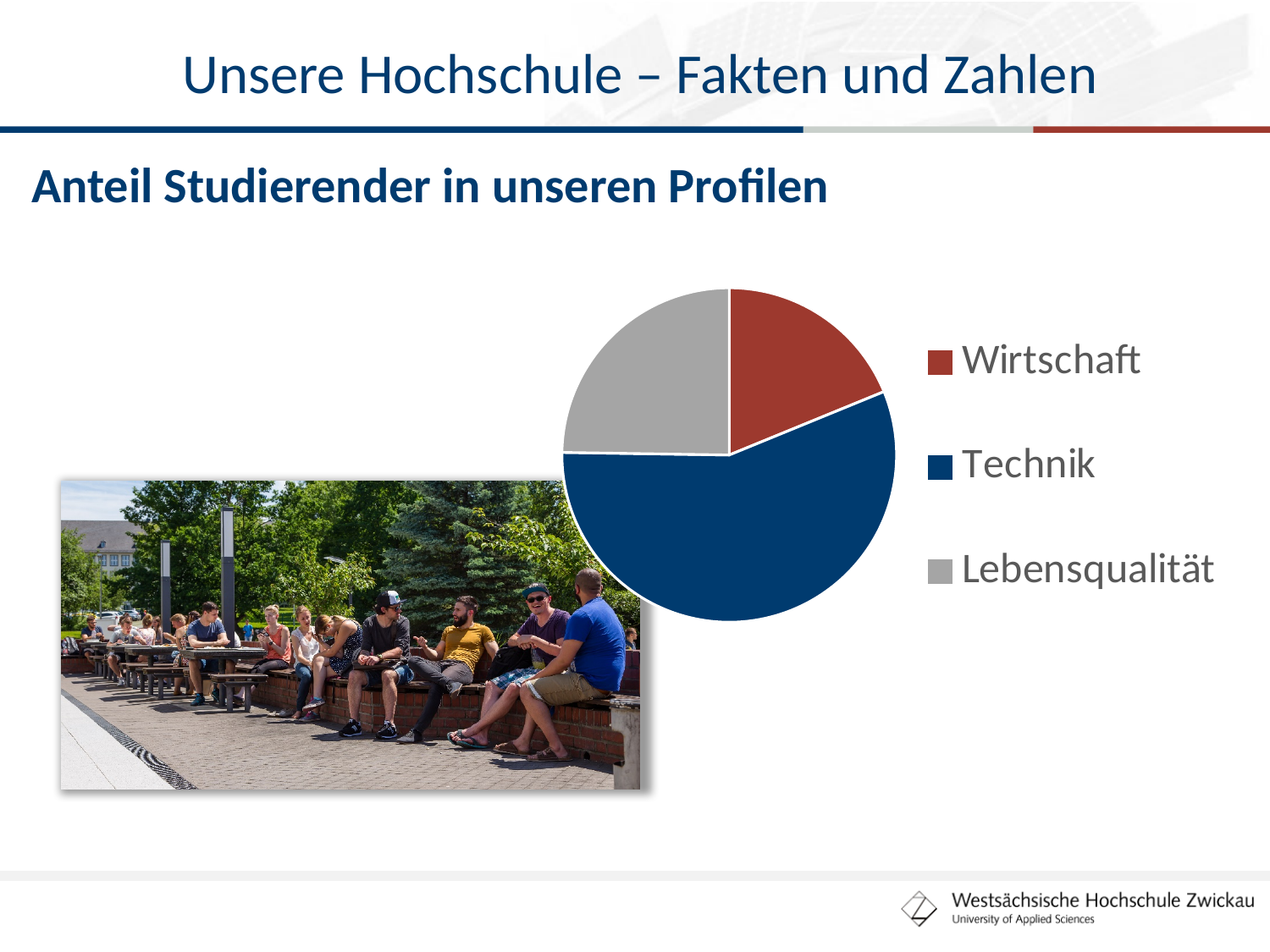
Which legend entry is shown in grey in the pie chart? Lebensqualität What colour is the Technik slice in the pie chart? blue Which slice is larger in the pie chart, Technik or Wirtschaft? Technik How many slices does the pie chart have? 3 How many entries does the legend of the pie chart list? 3 Which profile has the smallest share of students in the pie chart? Wirtschaft Which slice is larger in the pie chart, Technik or Lebensqualität? Technik Which slice is larger in the pie chart, Wirtschaft or Lebensqualität? Lebensqualität What kind of chart is shown on the slide? pie chart Which profile has the largest share of students in the pie chart? Technik